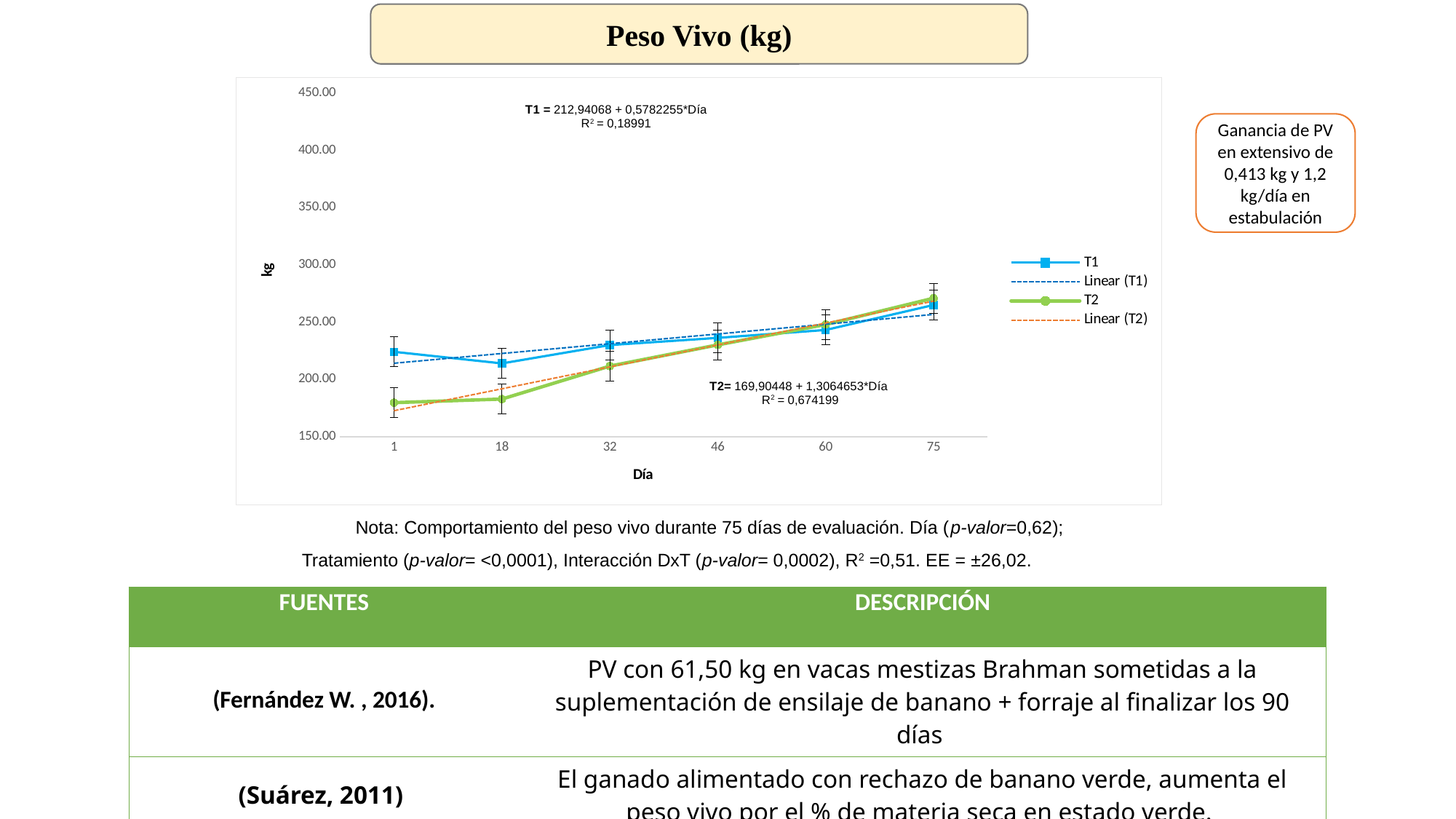
How many day values are marked along the x axis of the chart? 6 At which day does the T2 series reach its lowest value? 1 What is the R² value shown for the T1 linear trend? 0,18991 Is the value for T2 at day 18 greater or less than 200.00? less How many entries does the chart legend list? 4 Is the value for T1 at day 1 greater or less than 200.00? greater Does the T2 series rise or fall from day 1 to day 75? Rises What kind of chart is shown on the slide? Line chart At day 1, which series has the higher value, T1 or T2? T1 What is the title of the x axis of the chart? Día Is the value for T2 at day 1 greater or less than 200.00? less